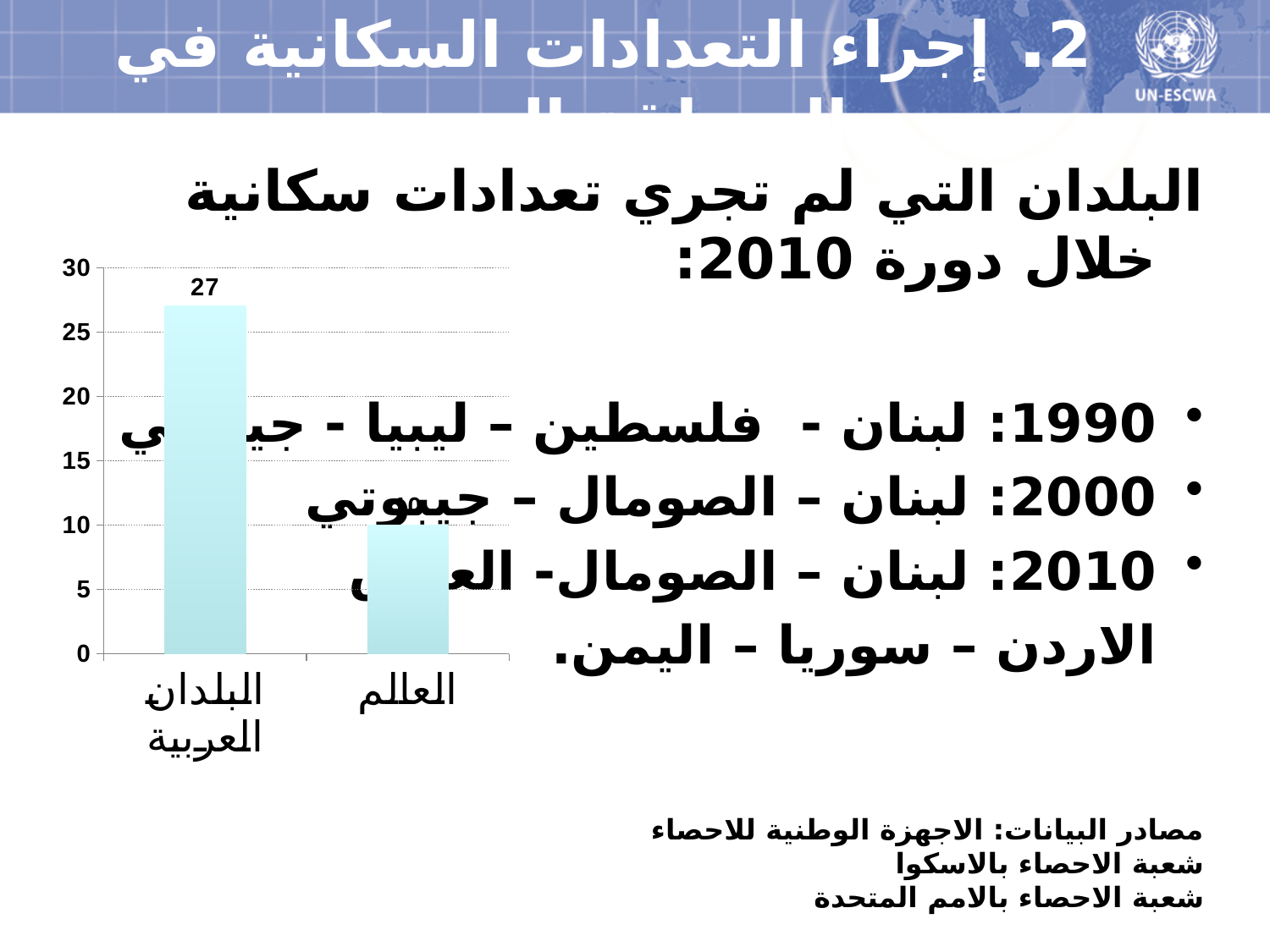
What is the maximum value shown on the vertical axis of the chart? 30 Is the value for العالم greater or less than 15? less Which is larger, the value for البلدان العربية or the value for العالم? البلدان العربية What colour are the bars in the chart? light blue What is the value for البلدان العربية? 27 What is the difference between the values for البلدان العربية and العالم? 17 Which category has the highest value? البلدان العربية What kind of chart is shown on the slide? bar chart Which category has the lowest value? العالم What is the value for العالم? 10 How many categories are shown in the chart? 2 Is the value for البلدان العربية greater or less than 25? greater